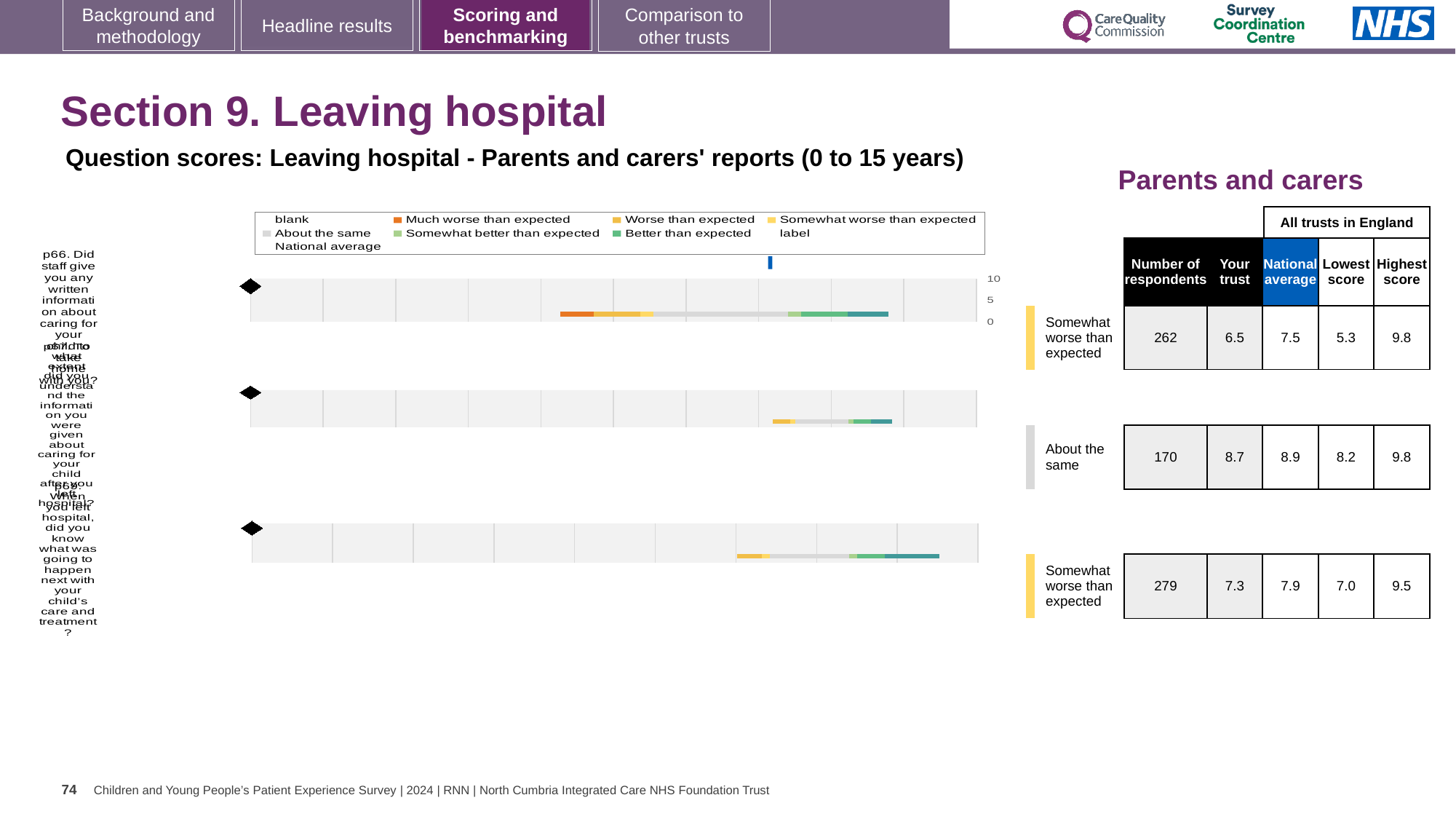
What kind of chart is used to show the question scores on this slide? bar chart What is the 'Your trust' score for the first question (p66, written information about caring for your child)? 6.5 Is the trust score for the second question (p67) higher or lower than the national average? lower What is the difference between the national average and the trust score for the third question (p68)? 0.6 What is the highest score across all trusts in England for the third question (p68, knowing what would happen next)? 9.5 What is the 'Your trust' score for the second question (p67)? 8.7 What is the national average for the first question (p66)? 7.5 Which question has the most respondents: p66, p67 or p68? p68 How many respondents answered the first question (p66)? 262 What colour represents 'Much worse than expected' in the legend? orange How many question score charts are shown on the slide? 3 What benchmark category is the first question (p66) placed in? Somewhat worse than expected